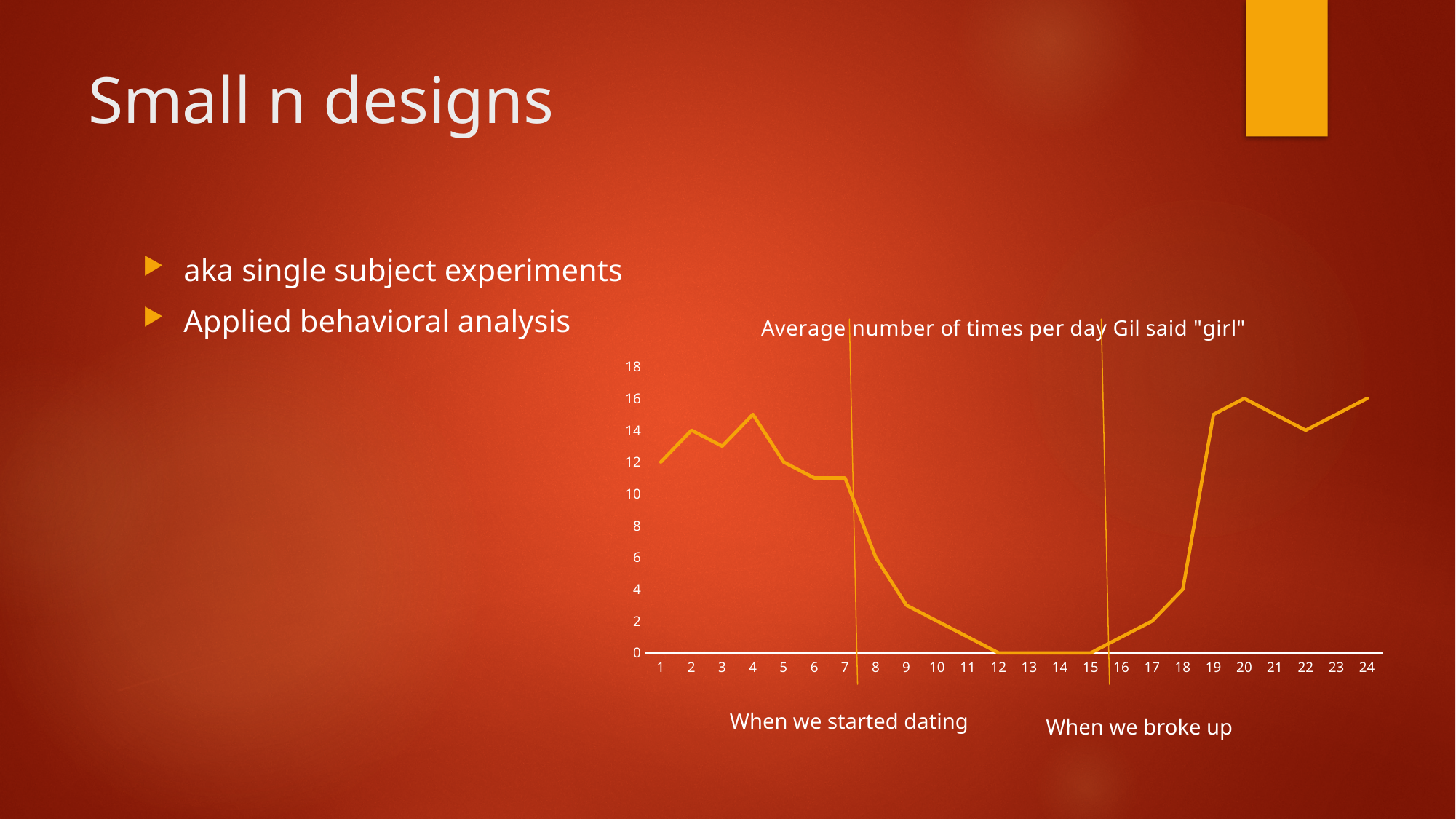
What is the title of the chart? Average number of times per day Gil said "girl" Is the value at point 9 greater or less than 6? less Is the value at point 4 greater or less than 14? greater What kind of chart is shown on the slide? line chart Does the line rise or fall between point 7 and point 12? fall How many data points are plotted along the x axis of the chart? 24 Is the value at point 18 greater or less than 6? less What event does the first vertical line on the chart mark? When we started dating What is the lowest value reached by the line on the chart? 0 What is the value at point 1 on the chart? 12 What is the value at point 12 on the chart? 0 Which is larger, the value at point 4 or the value at point 9? point 4